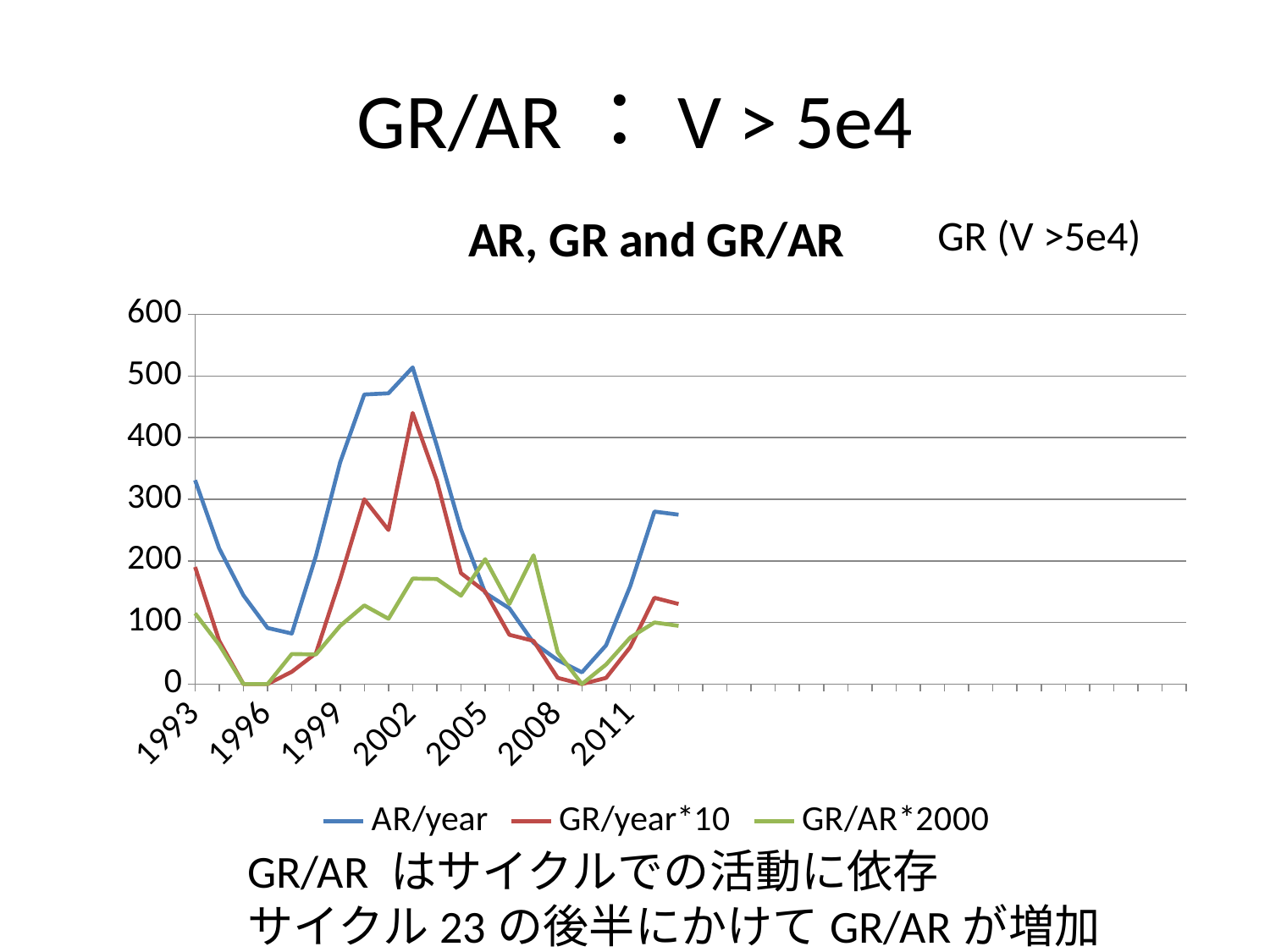
Is the peak value of AR/year around 2002 greater or less than 400? greater What is the title of the chart? AR, GR and GR/AR Does the AR/year series rise or fall from 1996 to 2002? rise Does the AR/year series rise or fall from 1993 to 1996? fall How many series does the legend list? 3 Is the value for AR/year in 1993 greater or less than 300? greater Which series has the lowest value in 2002? GR/AR*2000 Which series reaches the highest value anywhere on the chart? AR/year Is the value for GR/year*10 in 1996 greater or less than 100? less What kind of chart is shown on the slide? line chart What are the three series named in the legend? AR/year, GR/year*10, GR/AR*2000